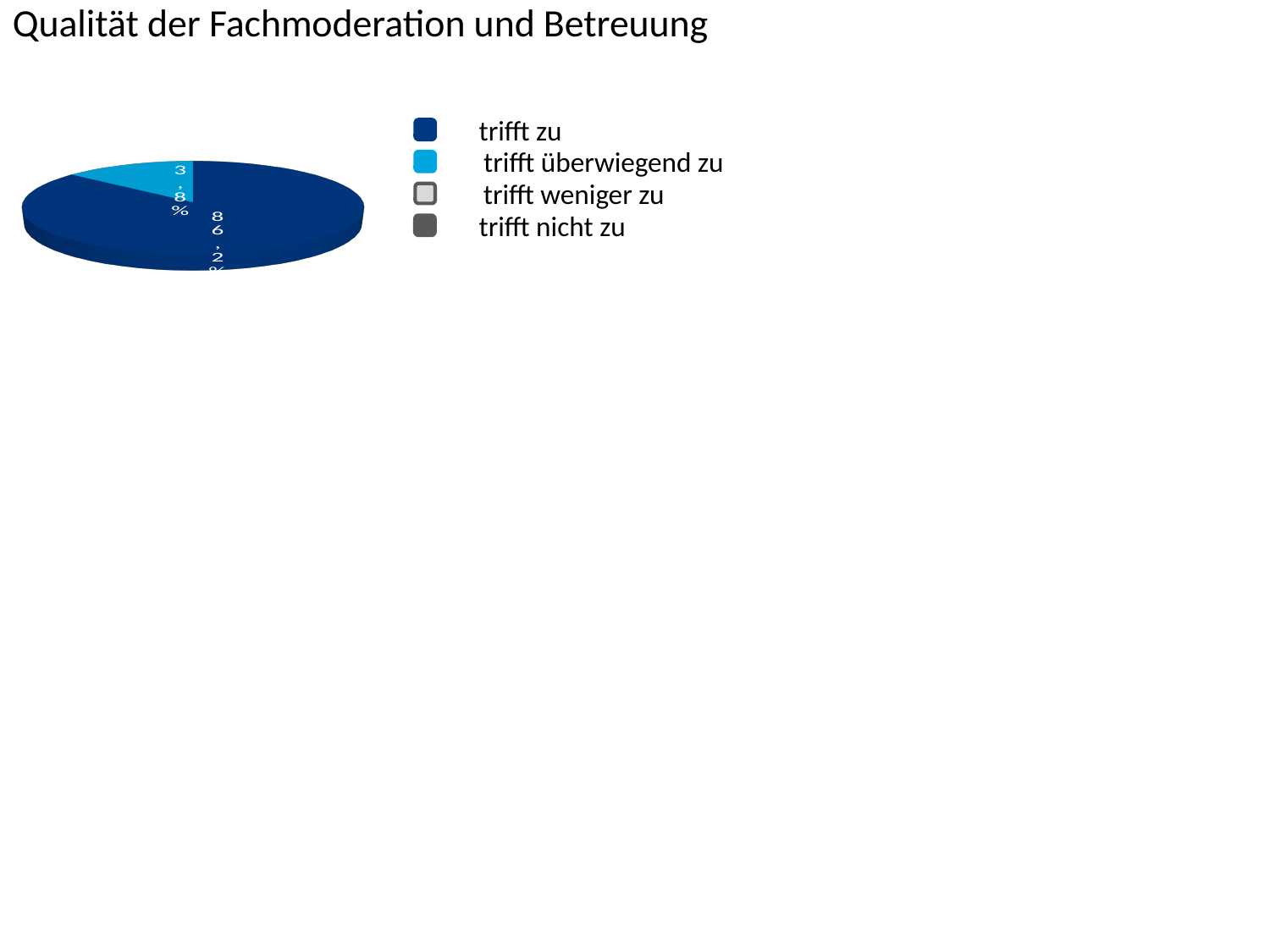
What colour represents 'trifft zu' in the legend? dark blue What kind of chart is shown on the slide? pie chart Which is larger, the 'trifft zu' slice or the 'trifft überwiegend zu' slice? trifft zu How many entries does the legend list? 4 What is the title of the slide above the chart? Qualität der Fachmoderation und Betreuung What percentage is shown for the 'trifft zu' slice? 86,2% Which of the two labelled slices is smaller, 'trifft zu' or 'trifft überwiegend zu'? trifft überwiegend zu Which category has the largest slice of the pie? trifft zu